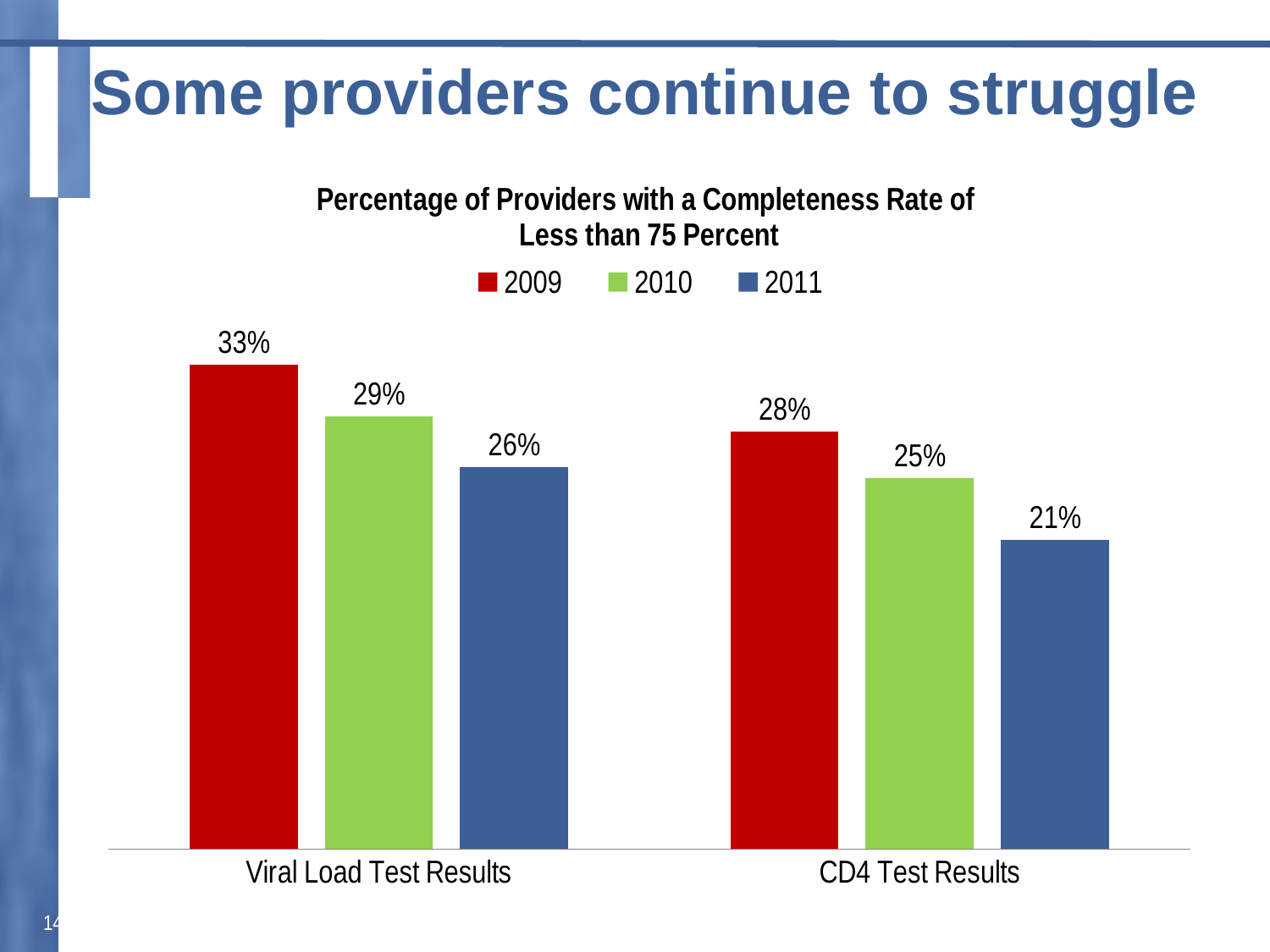
How many series does the legend list? 3 What is the value for 2009 in the Viral Load Test Results category? 33% Do the values for CD4 Test Results rise or fall from 2009 to 2011? Fall What is the difference between the 2009 and 2011 values for Viral Load Test Results? 7% Which is larger: the 2010 value for Viral Load Test Results or the 2010 value for CD4 Test Results? Viral Load Test Results What is the difference between the 2009 and 2011 values for CD4 Test Results? 7% What is the value for 2011 in the CD4 Test Results category? 21% What is the value for 2011 in the Viral Load Test Results category? 26% What kind of chart is shown on the slide? Bar chart Which year has the highest value for Viral Load Test Results? 2009 Which year has the lowest value for CD4 Test Results? 2011 What is the value for 2010 in the CD4 Test Results category? 25%